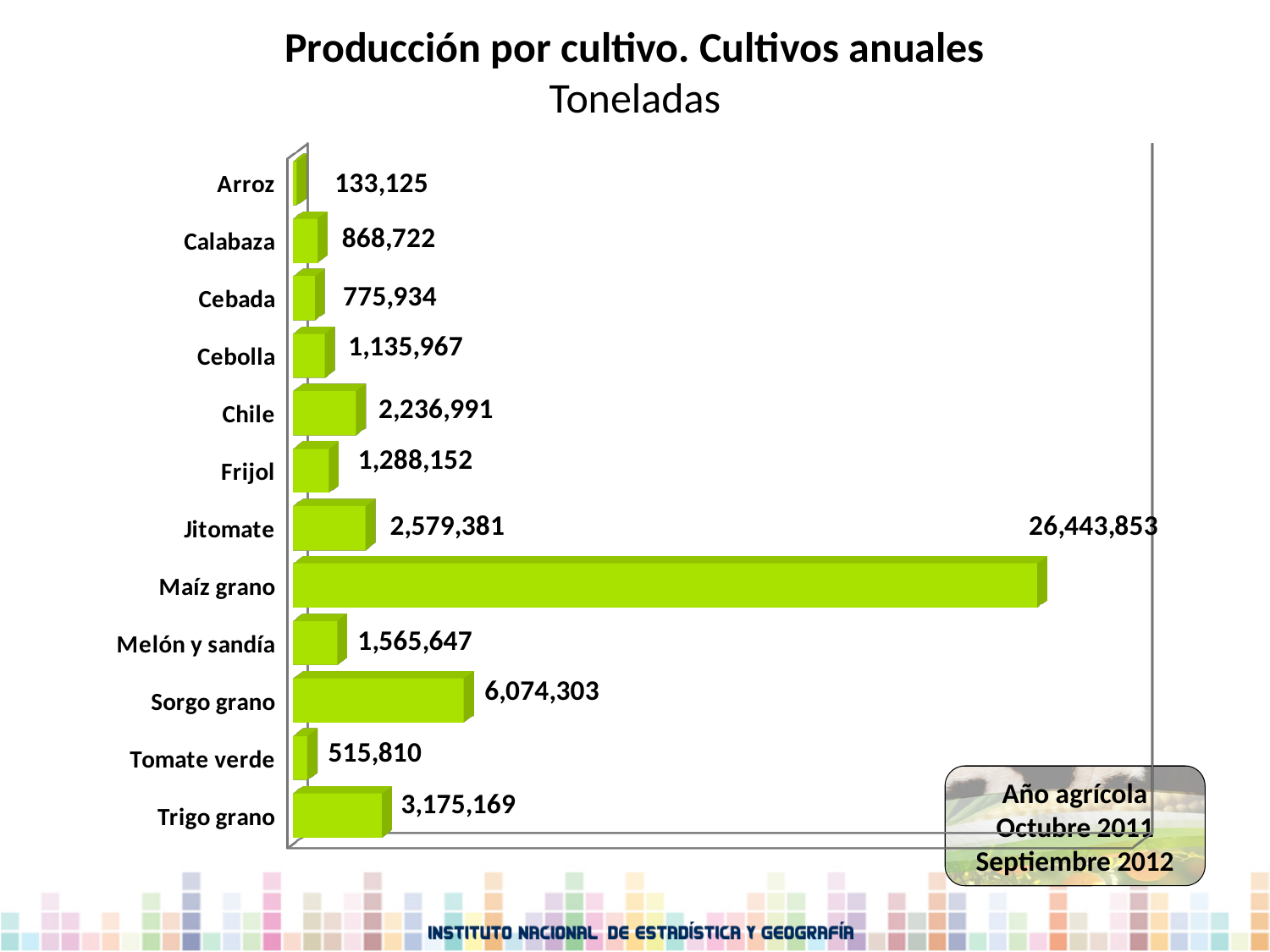
What is the production value for Melón y sandía? 1,565,647 What is the production value for Sorgo grano? 6,074,303 What is the difference in production between Calabaza and Cebada? 92,788 What type of chart is shown on the slide? bar chart Which crop has the lowest production? Arroz What is the difference in production between Sorgo grano and Trigo grano? 2,899,134 What is the production value for Maíz grano? 26,443,853 What unit of measurement is given in the chart's subtitle? Toneladas Which has a larger production, Chile or Jitomate? Jitomate How many crops (categories) are shown in the chart? 12 What is the production value for Tomate verde? 515,810 Which crop has the highest production? Maíz grano